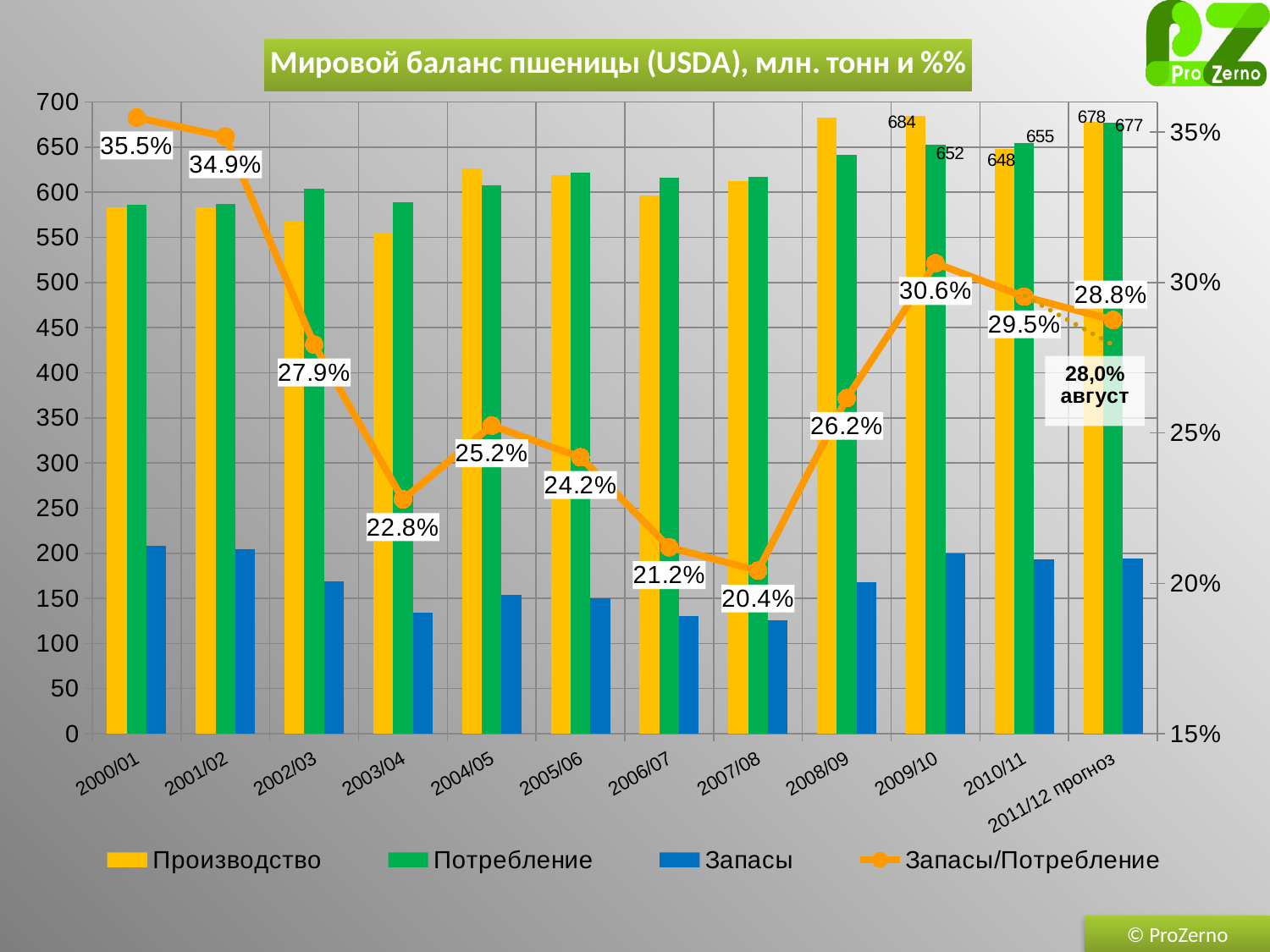
Is the value of Запасы for 2007/08 greater or less than 150? less How many series does the legend list? 4 Does Запасы/Потребление rise or fall from 2000/01 to 2007/08? fall What is the value of Производство for 2009/10? 684 What is the difference between Производство and Потребление in 2009/10? 32 What is the value of Запасы/Потребление for 2011/12 прогноз? 28.8% How many seasons are shown on the x axis? 12 What is the value of Потребление for 2010/11? 655 In which season is Запасы/Потребление the lowest? 2007/08 In which season is Запасы/Потребление the highest? 2000/01 What is the value of Запасы/Потребление for 2007/08? 20.4% In 2010/11, which is larger: Производство or Потребление? Потребление